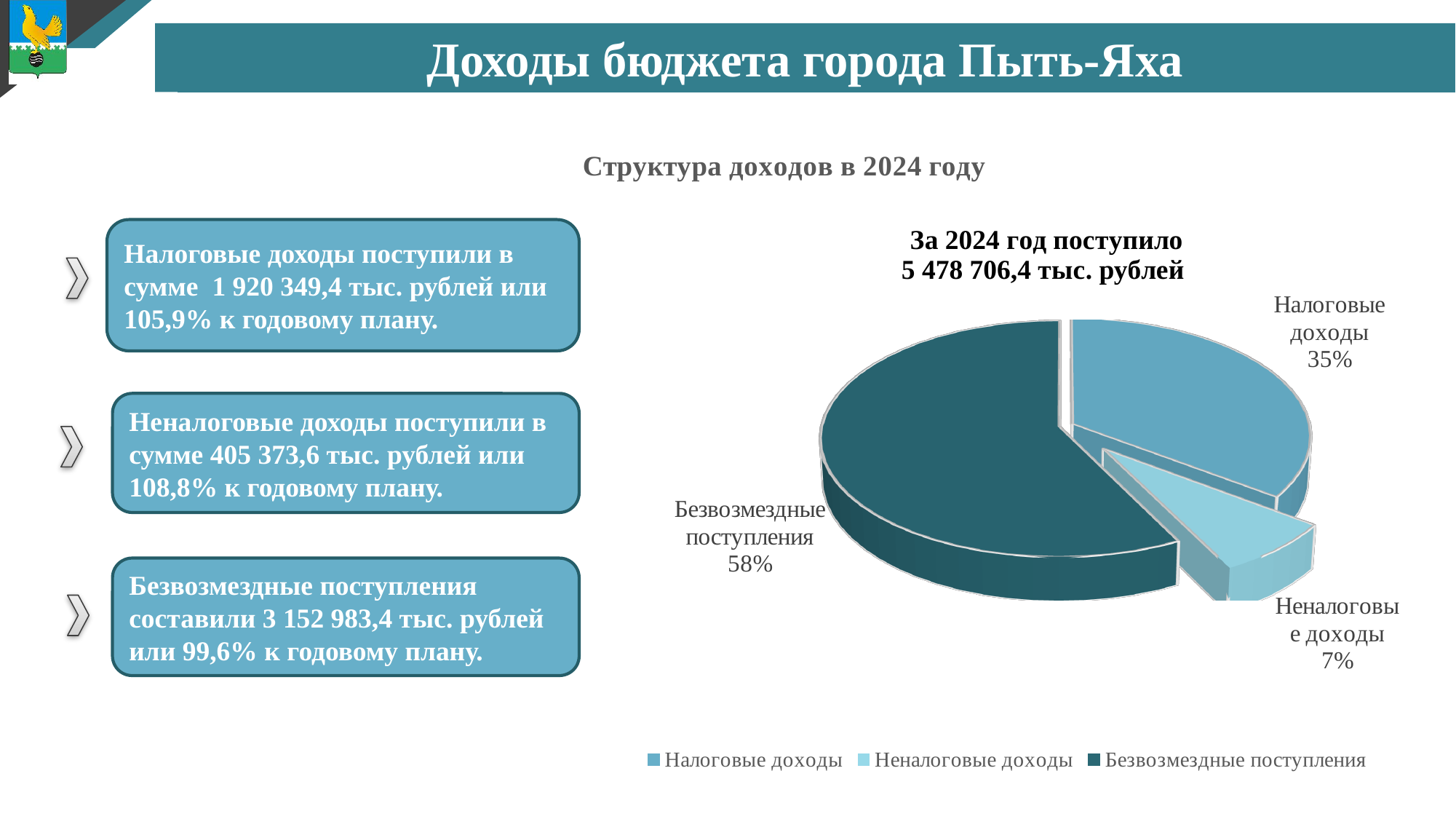
How many slices does the pie chart have? 3 What share of the pie does Неналоговые доходы have? 7% Which slice of the pie is the smallest? Неналоговые доходы What total amount does the chart title say was received in 2024? 5 478 706,4 тыс. рублей What share of the pie does Безвозмездные поступления have? 58% What is the difference in percentage points between the Безвозмездные поступления slice and the Налоговые доходы slice? 23 How many entries does the chart legend list? 3 Which legend entry is shown in the darkest colour? Безвозмездные поступления What share of the pie does Налоговые доходы have? 35% Which is larger: the Налоговые доходы slice or the Неналоговые доходы slice? Налоговые доходы Which slice of the pie is the largest? Безвозмездные поступления What kind of chart is shown on the slide? Pie chart